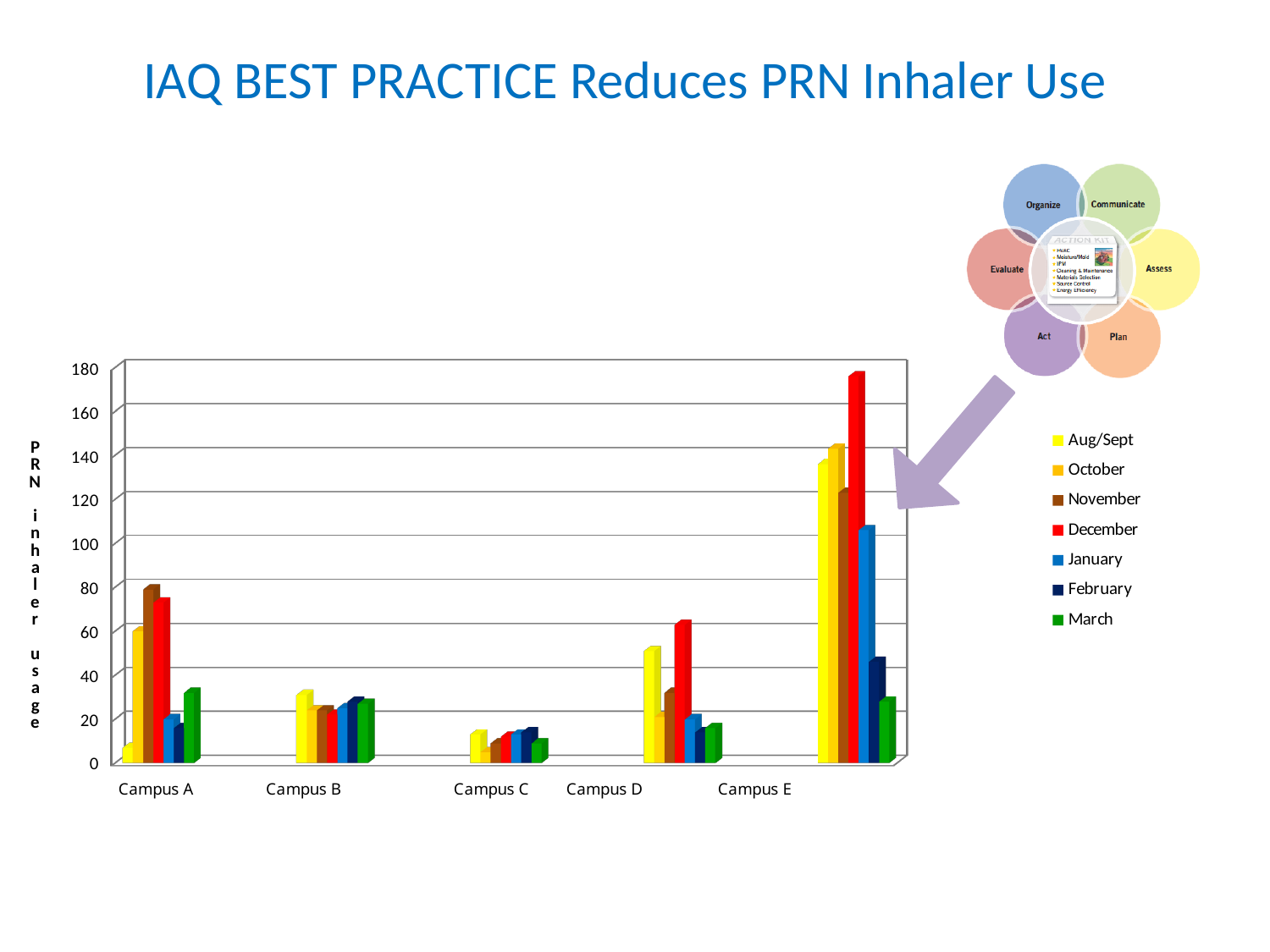
Is the March value for Campus C greater or less than 20? less Is the December value for Campus E greater or less than 160? greater Which month has the tallest bar for Campus E? December Is the December value for Campus D greater or less than 40? greater How many campuses are shown on the x axis of the chart? 5 Which campus has the highest December bar? Campus E Which campus has the lowest PRN inhaler usage across all months? Campus C What kind of chart is shown on the slide? bar chart How many series does the chart legend list? 7 What is the label on the vertical axis of the chart? PRN inhaler usage For Campus A, which is larger: the December value or the March value? December